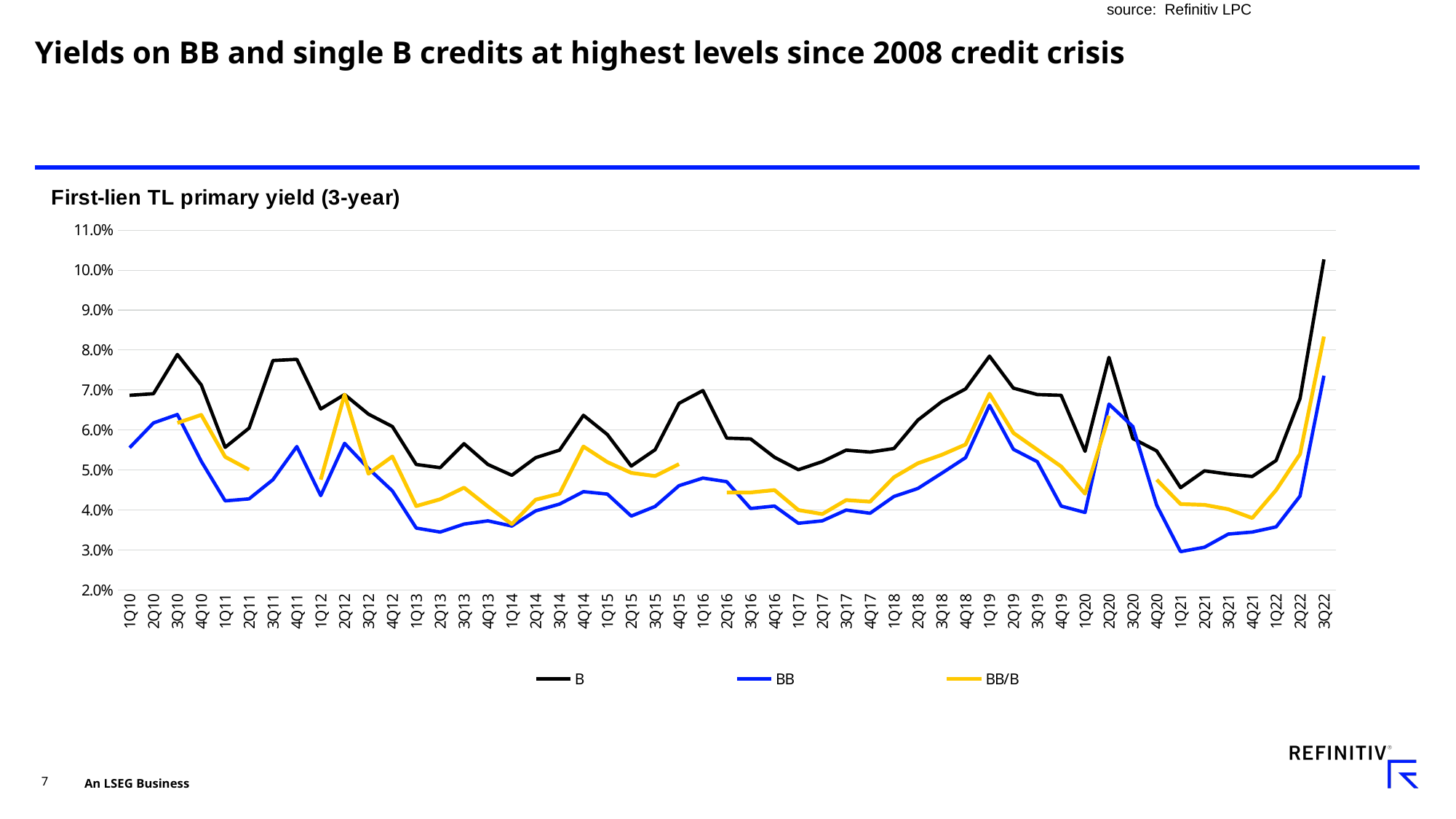
Which colour is used for the BB line? blue Which series has the higher value in 3Q22, B or BB? B In which quarter does the BB series reach its lowest value? 1Q21 Is the value for BB in 1Q21 greater or less than 4.0%? less Does the BB series rise or fall from 2Q20 to 1Q21? fall What kind of chart is shown on the slide? line chart What is the title of the chart? First-lien TL primary yield (3-year) Is the value for B in 3Q22 greater or less than 10.0%? greater Does the B series rise or fall from 1Q22 to 3Q22? rise How many series does the legend list? 3 Is the value for BB/B in 3Q22 greater or less than 8.0%? greater In which quarter does the B series reach its highest value? 3Q22